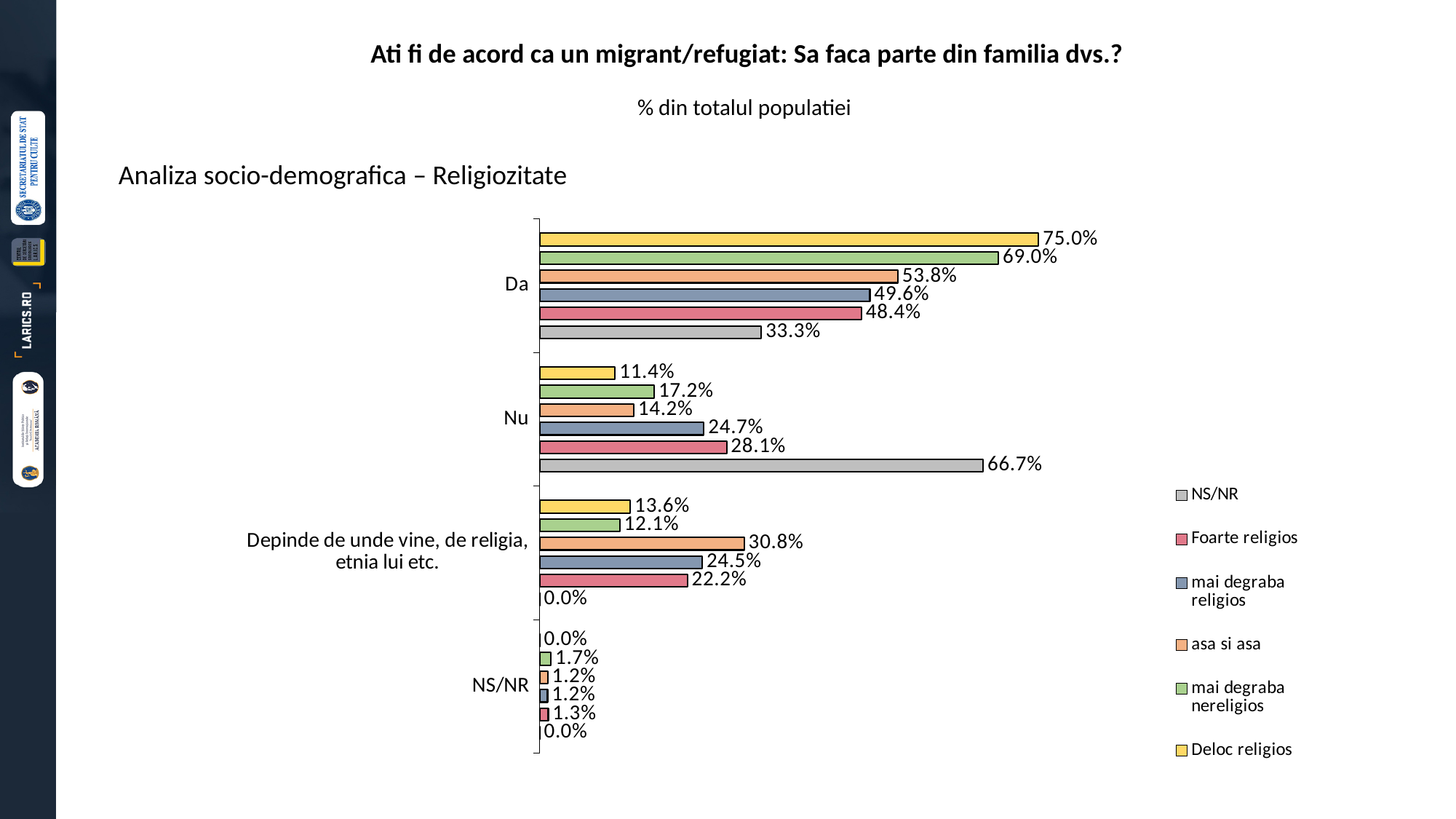
What is the value for 'mai degraba nereligios' in the 'NS/NR' category? 1.7% What kind of chart is shown on the slide? bar chart Which series has the highest value in the 'Nu' category? NS/NR How many series does the legend list? 6 What is the difference between 'Deloc religios' and 'mai degraba nereligios' in the 'Da' category? 6.0% How many response categories are shown on the vertical axis? 4 In the 'Nu' category, which is larger: 'mai degraba religios' or 'asa si asa'? mai degraba religios What is the value for 'asa si asa' in the 'Depinde de unde vine, de religia, etnia lui etc.' category? 30.8% Which series has the lowest value in the 'Da' category? NS/NR What is the subtitle shown under the chart's main title? % din totalul populatiei What is the value for 'Deloc religios' in the 'Da' category? 75.0% What is the value for 'Foarte religios' in the 'Nu' category? 28.1%